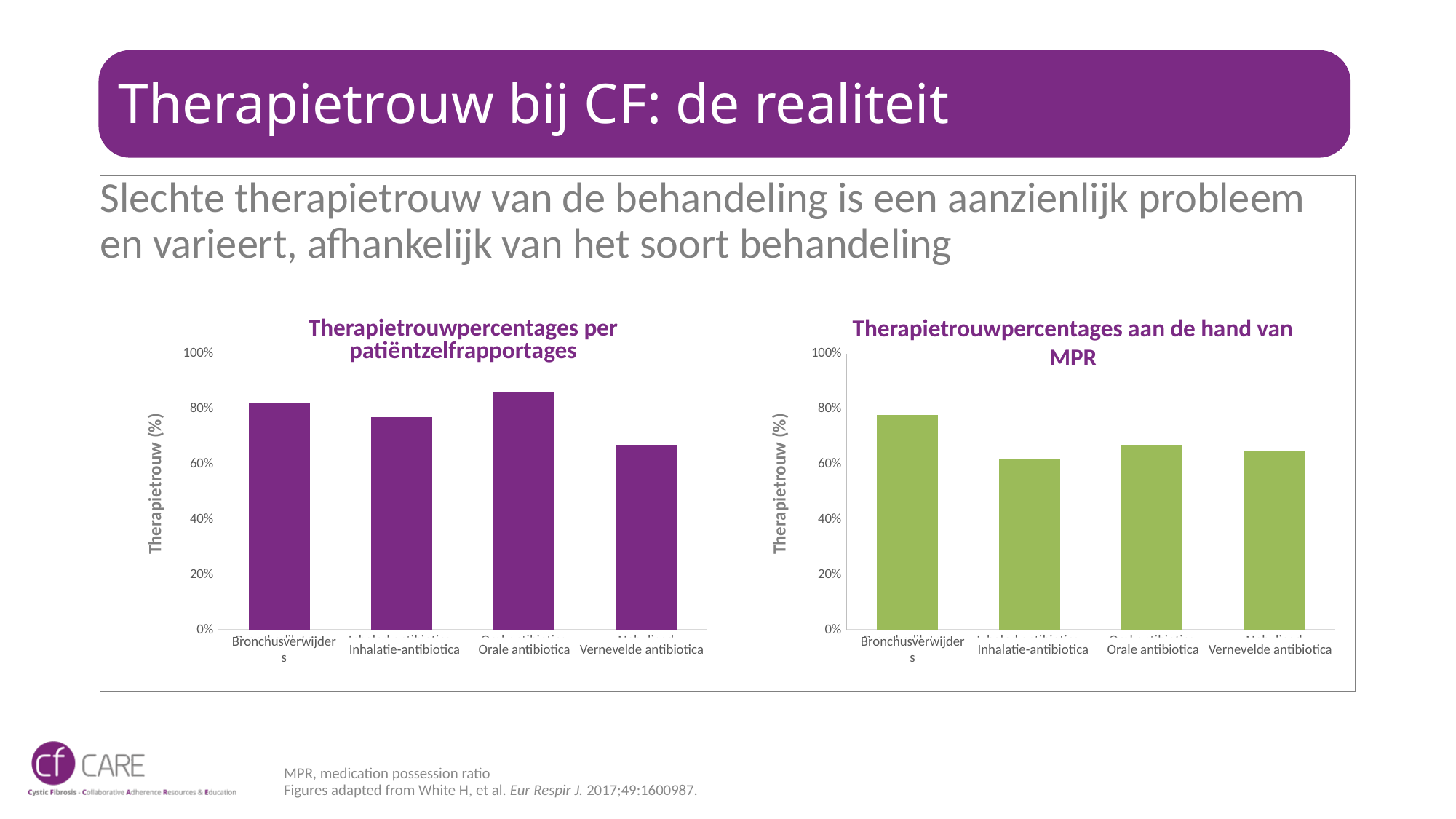
What is the y-axis label of the left chart (patiëntzelfrapportages)? Therapietrouw (%) In the right chart (MPR), which is larger: the value for Bronchusverwijders or the value for Orale antibiotica? Bronchusverwijders In the right chart (MPR), is the value for Bronchusverwijders greater or less than 80%? less In the left chart (patiëntzelfrapportages), is the value for Orale antibiotica greater or less than 80%? greater In the left chart (patiëntzelfrapportages), which category has the lowest value? Vernevelde antibiotica In the left chart (patiëntzelfrapportages), is the value for Inhalatie-antibiotica greater or less than 80%? less In the left chart (patiëntzelfrapportages), which category has the highest value? Orale antibiotica How many categories are shown in the right chart titled 'Therapietrouwpercentages aan de hand van MPR'? 4 What colour are the bars in the right chart (MPR)? Green What kind of chart is the left chart titled 'Therapietrouwpercentages per patiëntzelfrapportages'? Bar chart In the right chart (MPR), which category has the highest value? Bronchusverwijders